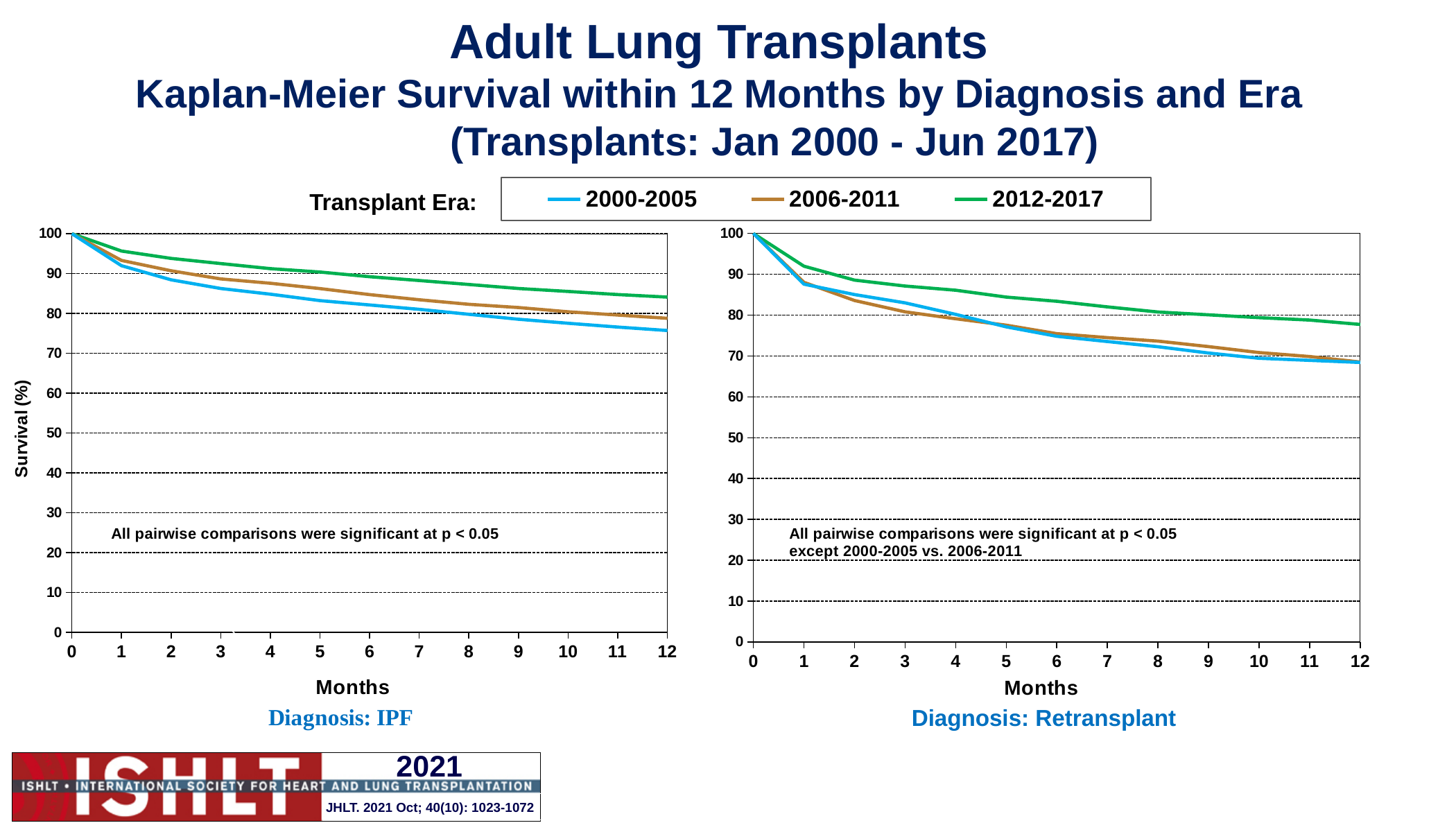
In the Diagnosis: Retransplant chart, which era has the highest survival at 12 months? 2012-2017 In the Diagnosis: IPF chart, is the survival for 2012-2017 at 12 months greater or less than 80? greater In the Diagnosis: Retransplant chart, is the survival for 2000-2005 at 12 months greater or less than 70? less In the Diagnosis: IPF chart, at 6 months, which era has higher survival, 2006-2011 or 2000-2005? 2006-2011 In the Diagnosis: IPF chart, which era has the lowest survival at 12 months? 2000-2005 In the Diagnosis: IPF chart, is the survival for 2000-2005 at 12 months greater or less than 80? less In the Diagnosis: IPF chart, which era has the highest survival at 12 months? 2012-2017 How many transplant eras does the legend list? 3 What is the label on the x axis of the Diagnosis: Retransplant chart? Months What kind of chart is the Diagnosis: IPF chart? line chart In the Diagnosis: IPF chart, what is the survival value for every era at month 0? 100 In the Diagnosis: Retransplant chart, do the survival curves rise or fall as months increase? fall